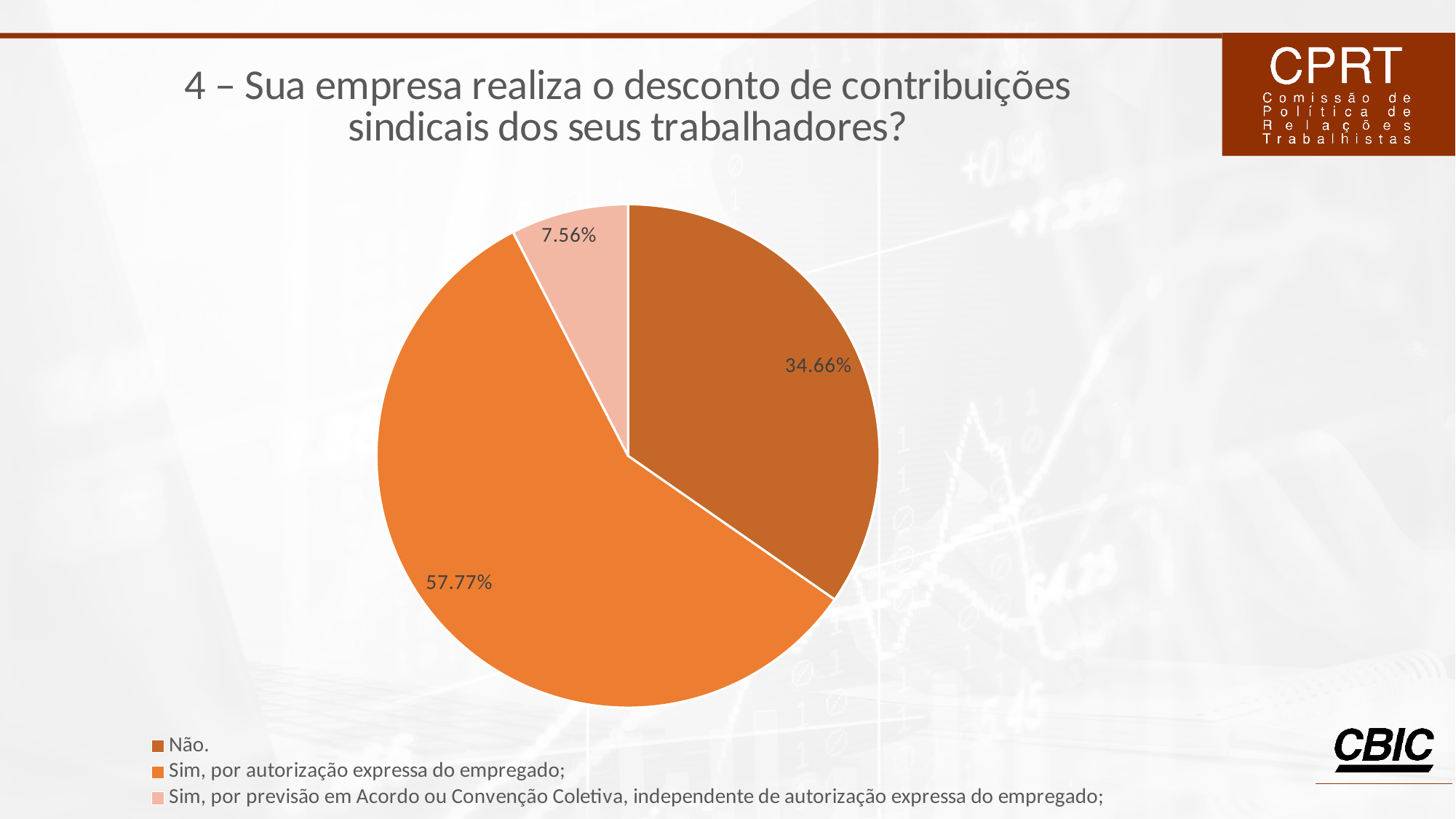
Which category has the smallest slice of the pie? Sim, por previsão em Acordo ou Convenção Coletiva, independente de autorização expressa do empregado; What share of the pie corresponds to "Sim, por autorização expressa do empregado;"? 57.77% How many slices does the pie chart have? 3 How many entries does the legend list? 3 What kind of chart is shown on the slide? pie chart What share of the pie corresponds to "Sim, por previsão em Acordo ou Convenção Coletiva, independente de autorização expressa do empregado;"? 7.56% What is the difference in percentage points between "Não." and "Sim, por previsão em Acordo ou Convenção Coletiva, independente de autorização expressa do empregado;"? 27.10 What share of the pie corresponds to "Não."? 34.66% Which category has the largest slice of the pie? Sim, por autorização expressa do empregado; Which is larger: the slice for "Não." or the slice for "Sim, por autorização expressa do empregado;"? Sim, por autorização expressa do empregado; What is the title of the chart on the slide? 4 – Sua empresa realiza o desconto de contribuições sindicais dos seus trabalhadores? What is the difference in percentage points between "Sim, por autorização expressa do empregado;" and "Não."? 23.11